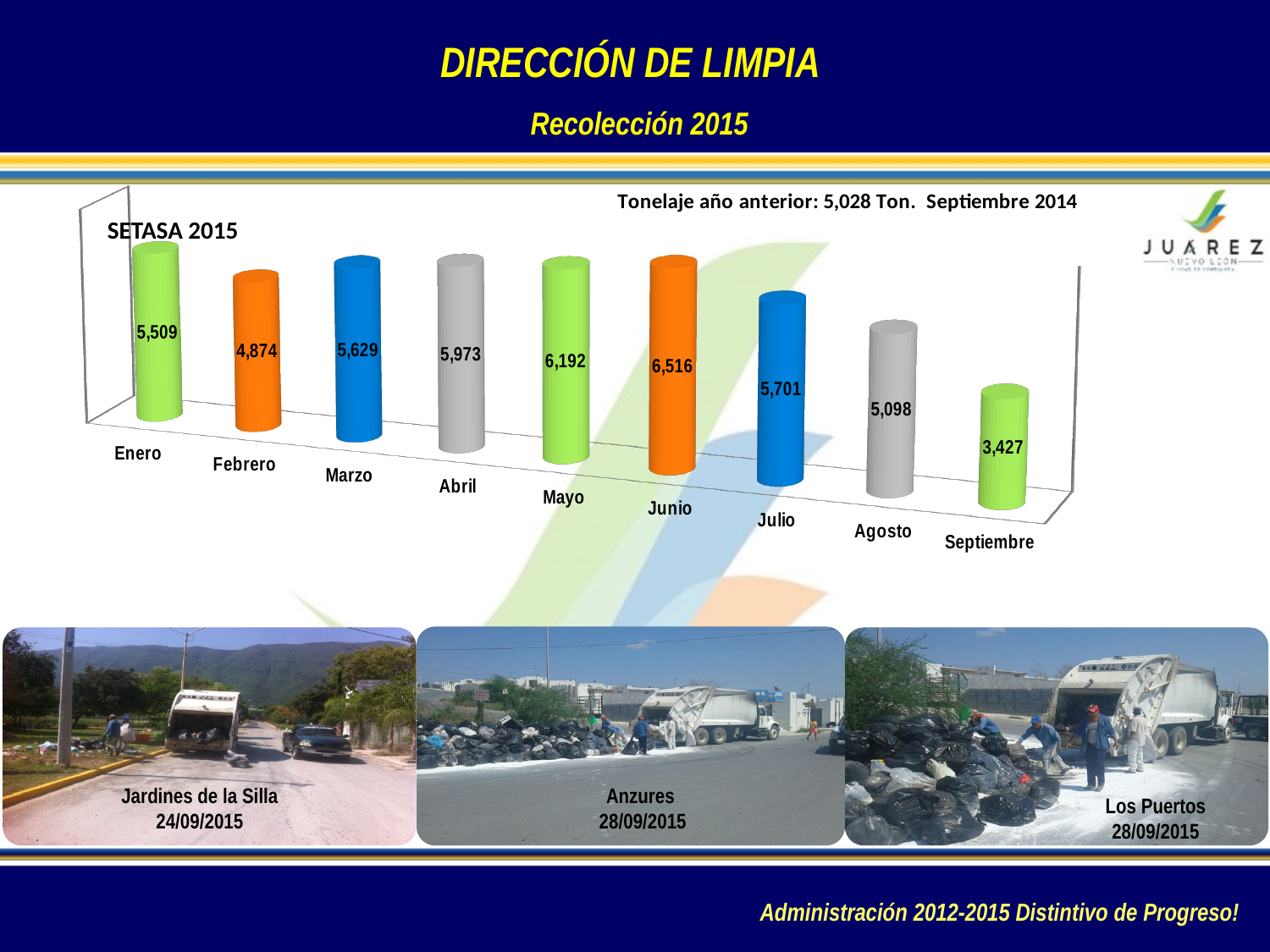
What is the value for Junio in the SETASA 2015 chart? 6,516 What kind of chart is the SETASA 2015 chart? bar chart Do the values in the SETASA 2015 chart rise or fall from Junio to Septiembre? fall What is the difference between the values for Mayo and Febrero in the SETASA 2015 chart? 1,318 What is the value for Abril in the SETASA 2015 chart? 5,973 What is the value for Septiembre in the SETASA 2015 chart? 3,427 Which month has the lowest value in the SETASA 2015 chart? Septiembre Which is larger in the SETASA 2015 chart, the value for Marzo or the value for Agosto? Marzo Which month has the highest value in the SETASA 2015 chart? Junio What tonnage for Septiembre 2014 is stated above the SETASA 2015 chart? 5,028 Ton. How many months are shown in the SETASA 2015 chart? 9 What is the difference between the values for Junio and Septiembre in the SETASA 2015 chart? 3,089